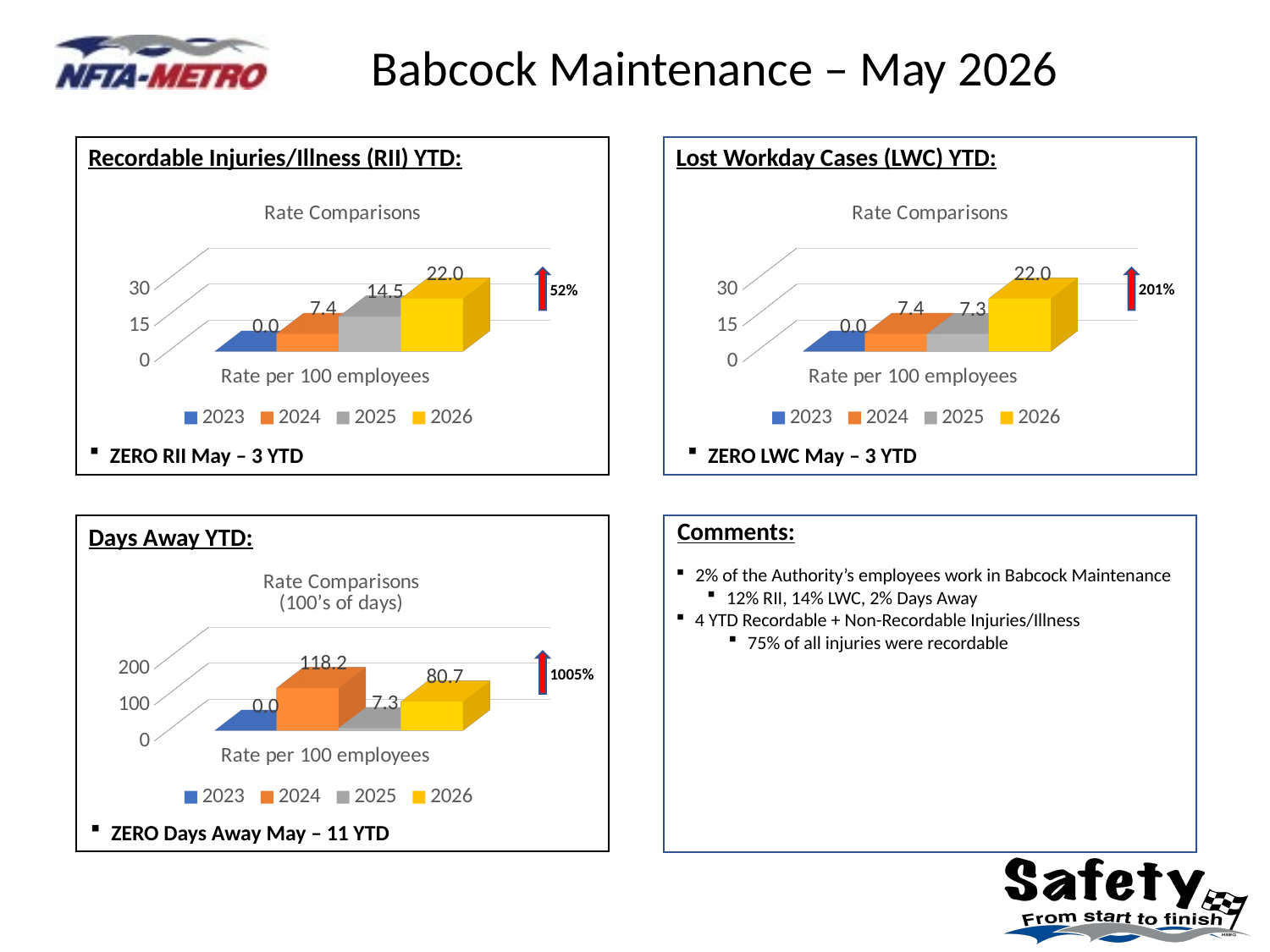
In the Lost Workday Cases (LWC) YTD chart, what is the rate per 100 employees for 2025? 7.3 What kind of chart is the Recordable Injuries/Illness (RII) YTD chart? bar chart In the Recordable Injuries/Illness (RII) YTD chart, what is the rate per 100 employees for 2025? 14.5 In the Recordable Injuries/Illness (RII) YTD chart, what is the rate per 100 employees for 2026? 22.0 In the Days Away YTD chart, which is larger, the 2024 value or the 2026 value? 2024 In the Recordable Injuries/Illness (RII) YTD chart, do the values rise or fall from 2023 to 2026? rise In the Days Away YTD chart, what is the rate per 100 employees for 2024? 118.2 In the Lost Workday Cases (LWC) YTD chart, which year has the highest rate? 2026 In the Recordable Injuries/Illness (RII) YTD chart, what is the difference between the 2026 and 2024 rates? 14.6 How many series does the legend list in the Days Away YTD chart? 4 In the Lost Workday Cases (LWC) YTD chart, which year has the lowest rate? 2023 In the Days Away YTD chart, what is the difference between the 2024 and 2026 values? 37.5